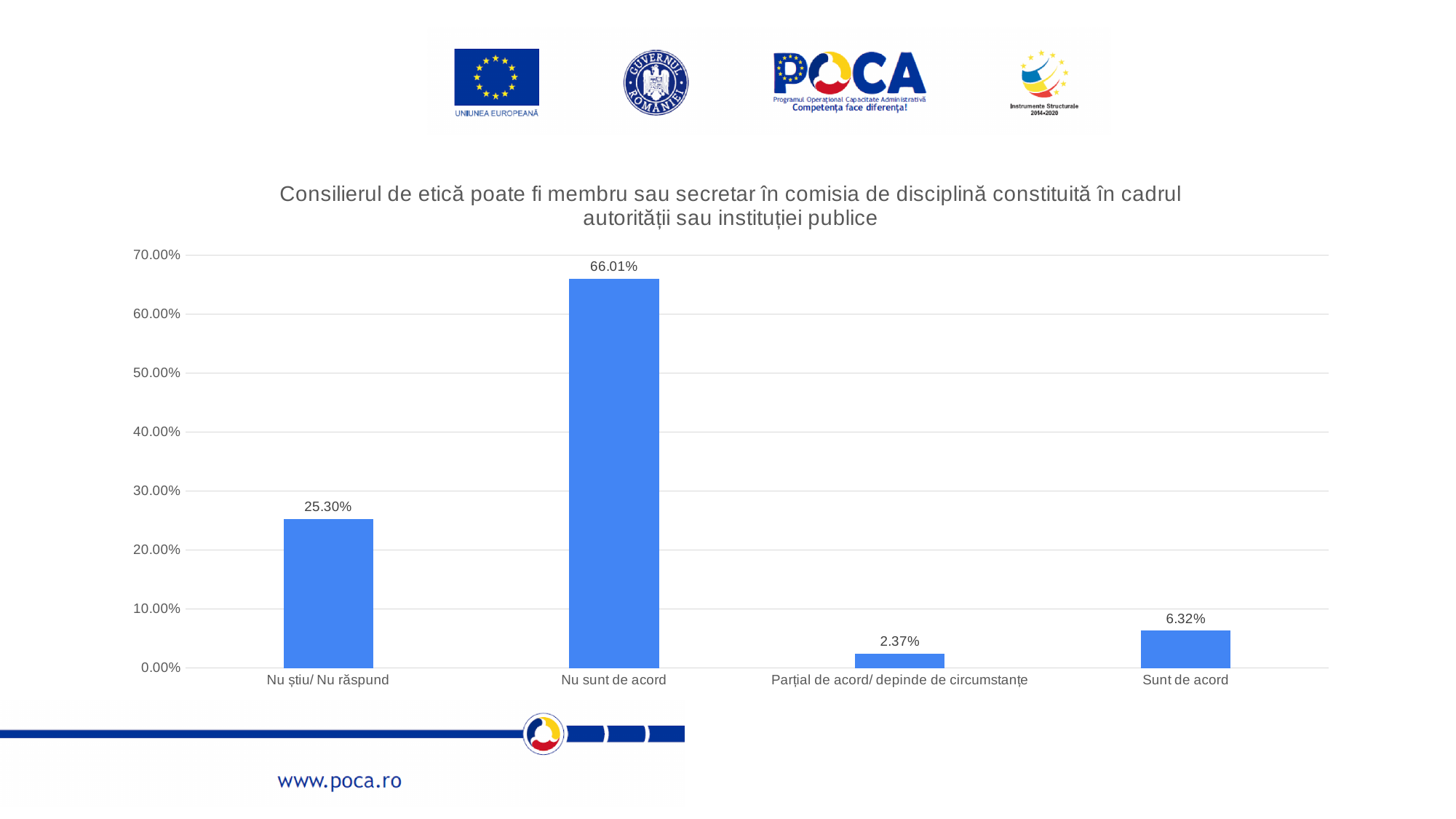
What is the value for "Sunt de acord"? 6.32% What is the value for "Nu știu/ Nu răspund"? 25.30% What is the value for "Parțial de acord/ depinde de circumstanțe"? 2.37% What is the value for "Nu sunt de acord"? 66.01% What is the difference between the values for "Sunt de acord" and "Parțial de acord/ depinde de circumstanțe"? 3.95% How many categories are shown on the x axis? 4 What is the difference between the values for "Nu sunt de acord" and "Nu știu/ Nu răspund"? 40.71% Which is larger, the value for "Sunt de acord" or the value for "Parțial de acord/ depinde de circumstanțe"? Sunt de acord Which category has the highest value? Nu sunt de acord Which category has the lowest value? Parțial de acord/ depinde de circumstanțe What kind of chart is shown on the slide? bar chart Is the value for "Nu știu/ Nu răspund" greater or less than 30.00%? less